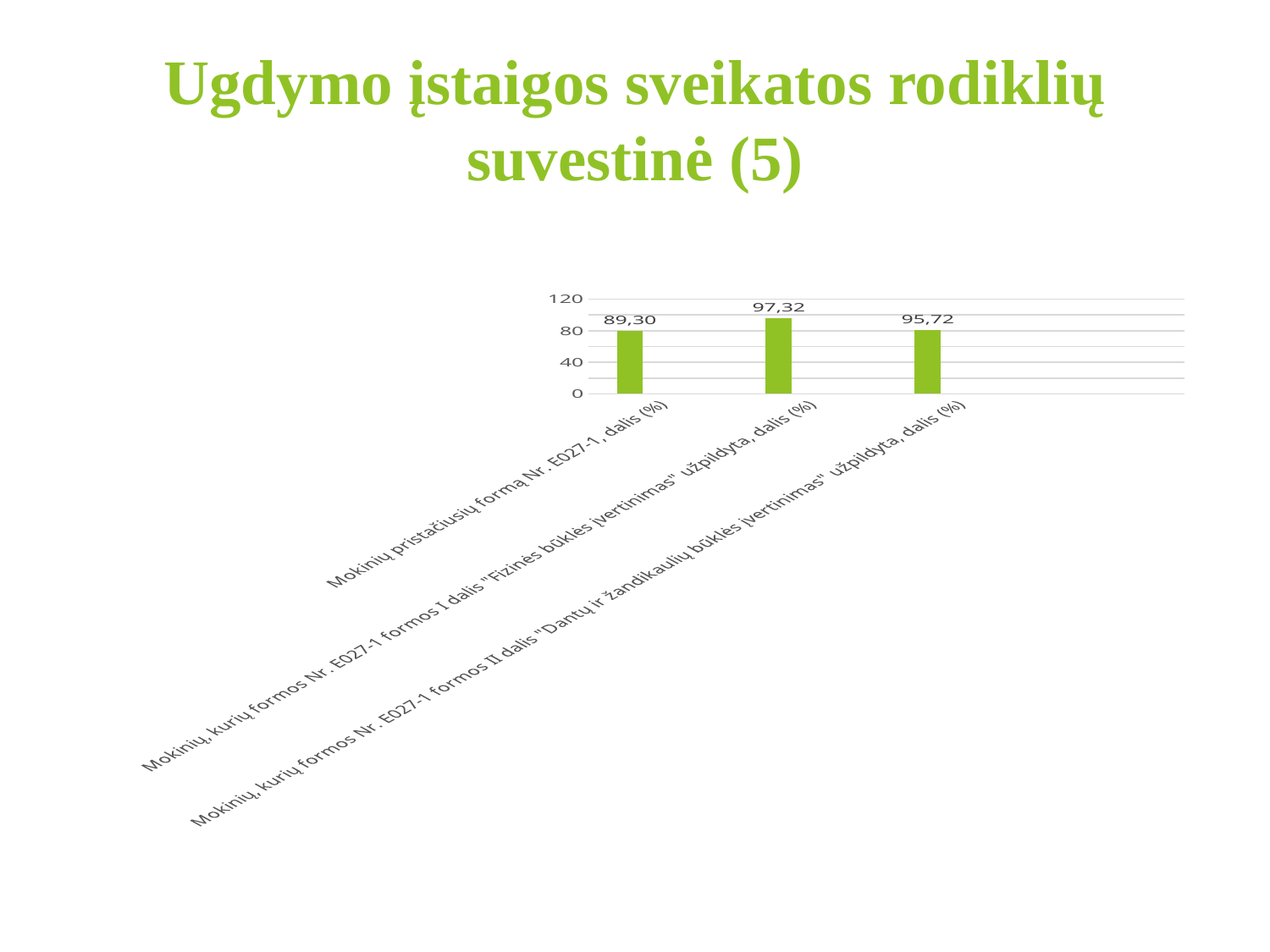
What kind of chart is shown on the slide? bar chart How many categories are shown in the chart? 3 Which is larger: the value for the II dalis "Dantų ir žandikaulių būklės įvertinimas" category or the value for "Mokinių pristačiusių formą Nr. E027-1, dalis (%)"? II dalis "Dantų ir žandikaulių būklės įvertinimas" category (95,72) What is the value for "Mokinių pristačiusių formą Nr. E027-1, dalis (%)"? 89,30 What is the difference between the value for the I dalis category (97,32) and the II dalis category (95,72)? 1,60 What is the highest value shown on the vertical axis? 120 What is the value for the category about form I dalis "Fizinės būklės įvertinimas" being filled in? 97,32 What is the value for the category about form II dalis "Dantų ir žandikaulių būklės įvertinimas" being filled in? 95,72 Which category has the highest value? Mokinių, kurių formos Nr. E027-1 formos I dalis "Fizinės būklės įvertinimas" užpildyta, dalis (%) What is the difference between the highest value (97,32) and the lowest value (89,30)? 8,02 Which category has the lowest value? Mokinių pristačiusių formą Nr. E027-1, dalis (%)